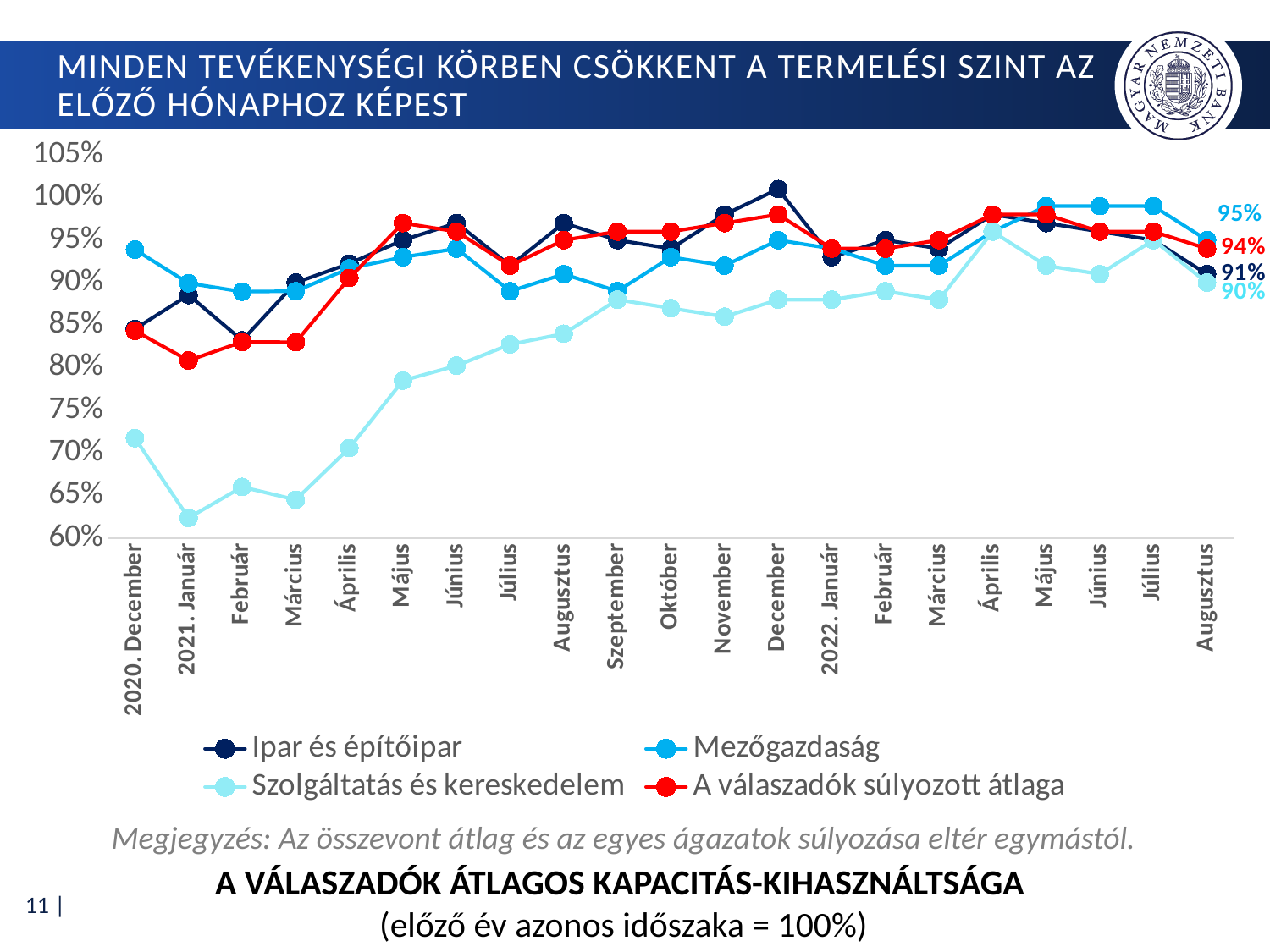
What is the value for A válaszadók súlyozott átlaga in Augusztus 2022? 94% Which series has the lowest value in Augusztus 2022? Szolgáltatás és kereskedelem Is the value for Ipar és építőipar in December 2021 greater or less than 95%? greater Is the value for Szolgáltatás és kereskedelem in 2021. Január greater or less than 65%? less How many series does the legend list? 4 What is the value for Mezőgazdaság in Augusztus 2022? 95% In Augusztus 2022, which is larger: Mezőgazdaság or Ipar és építőipar? Mezőgazdaság What is the value for Ipar és építőipar in Augusztus 2022? 91% What is the difference between the Mezőgazdaság and Szolgáltatás és kereskedelem values in Augusztus 2022? 5 percentage points Does the Szolgáltatás és kereskedelem series rise or fall from 2021. Január to Április 2022? Rise What kind of chart is shown on the slide? Line chart What is the value for Szolgáltatás és kereskedelem in Augusztus 2022? 90%